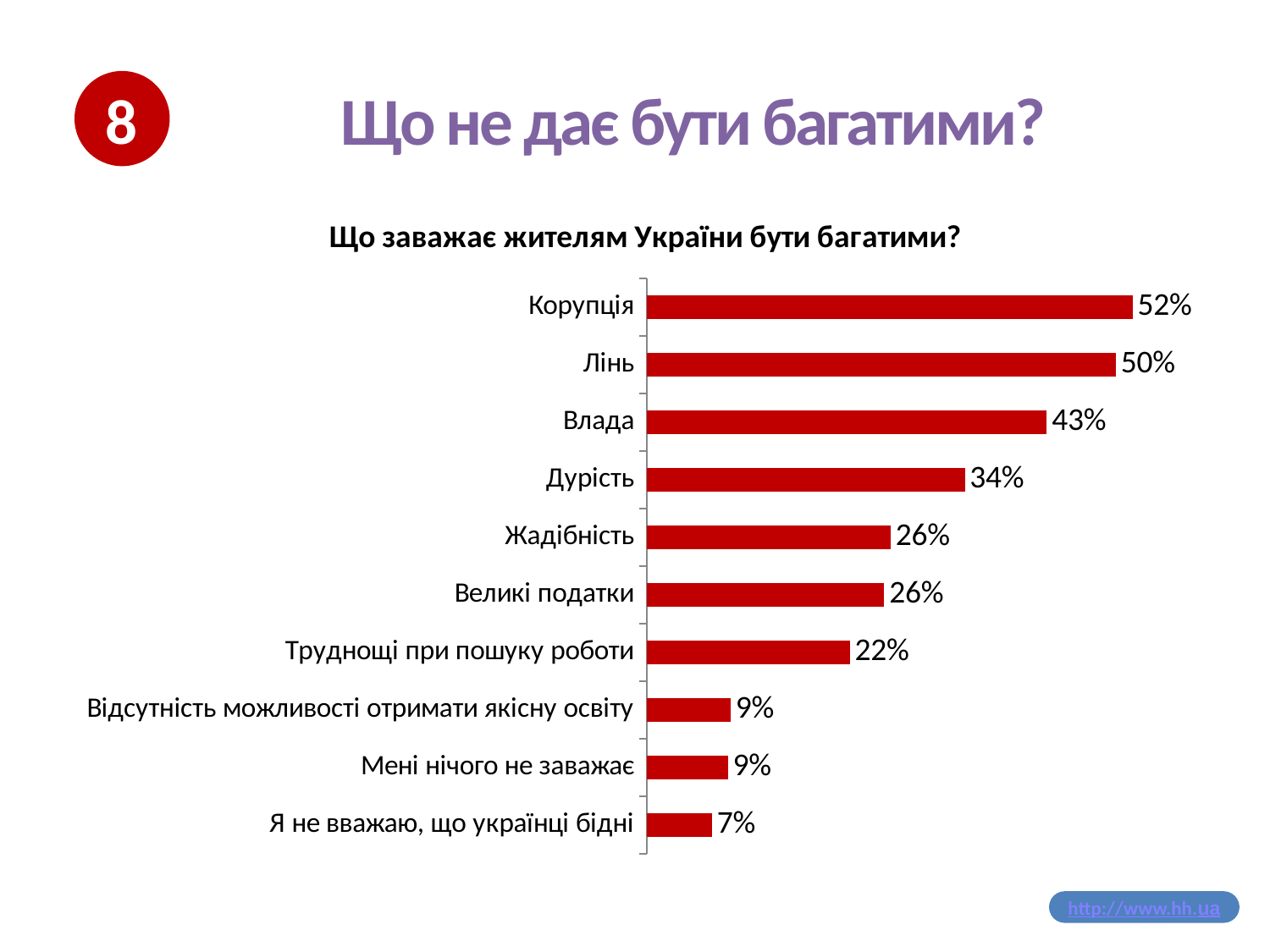
What kind of chart is shown on the slide? Bar chart Which category has the highest value? Корупція Which is larger, the value for Влада or the value for Дурість? Влада What is the value for Корупція? 52% How many categories are shown in the chart? 10 What is the difference between the values for Корупція and Лінь? 2% What is the value for Влада? 43% What is the difference between the values for Дурість and Жадібність? 8% What colour are the bars in the chart? Red What is the value for Труднощі при пошуку роботи? 22% What is the title of the chart? Що заважає жителям України бути багатими? Which category has the lowest value? Я не вважаю, що українці бідні